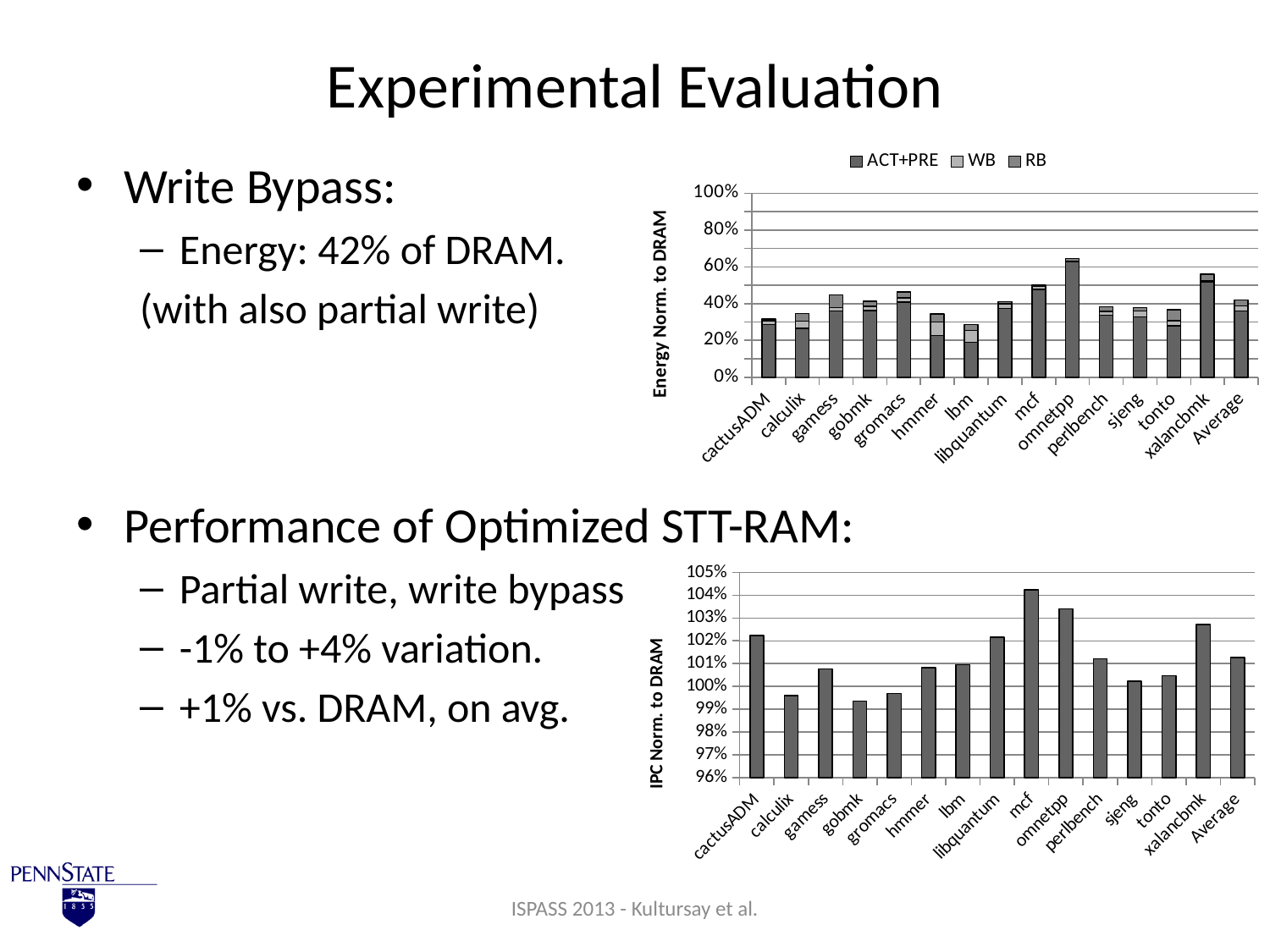
What kind of chart is the bottom chart (IPC Norm. to DRAM)? bar chart In the top chart (Energy Norm. to DRAM), which category has the highest total energy? omnetpp How many series does the legend of the top chart (Energy Norm. to DRAM) list? 3 In the top chart (Energy Norm. to DRAM), is the total value for lbm greater or less than 40%? less In the bottom chart (IPC Norm. to DRAM), which is larger, the value for mcf or the value for calculix? mcf In the bottom chart (IPC Norm. to DRAM), is the value for gobmk greater or less than 100%? less In the bottom chart (IPC Norm. to DRAM), is the value for mcf greater or less than 103%? greater In the top chart (Energy Norm. to DRAM), which is larger, the total for omnetpp or the total for mcf? omnetpp In the bottom chart (IPC Norm. to DRAM), which category has the highest value? mcf How many categories are shown on the x axis of the top chart (Energy Norm. to DRAM)? 15 In the top chart (Energy Norm. to DRAM), which category has the lowest total energy? lbm